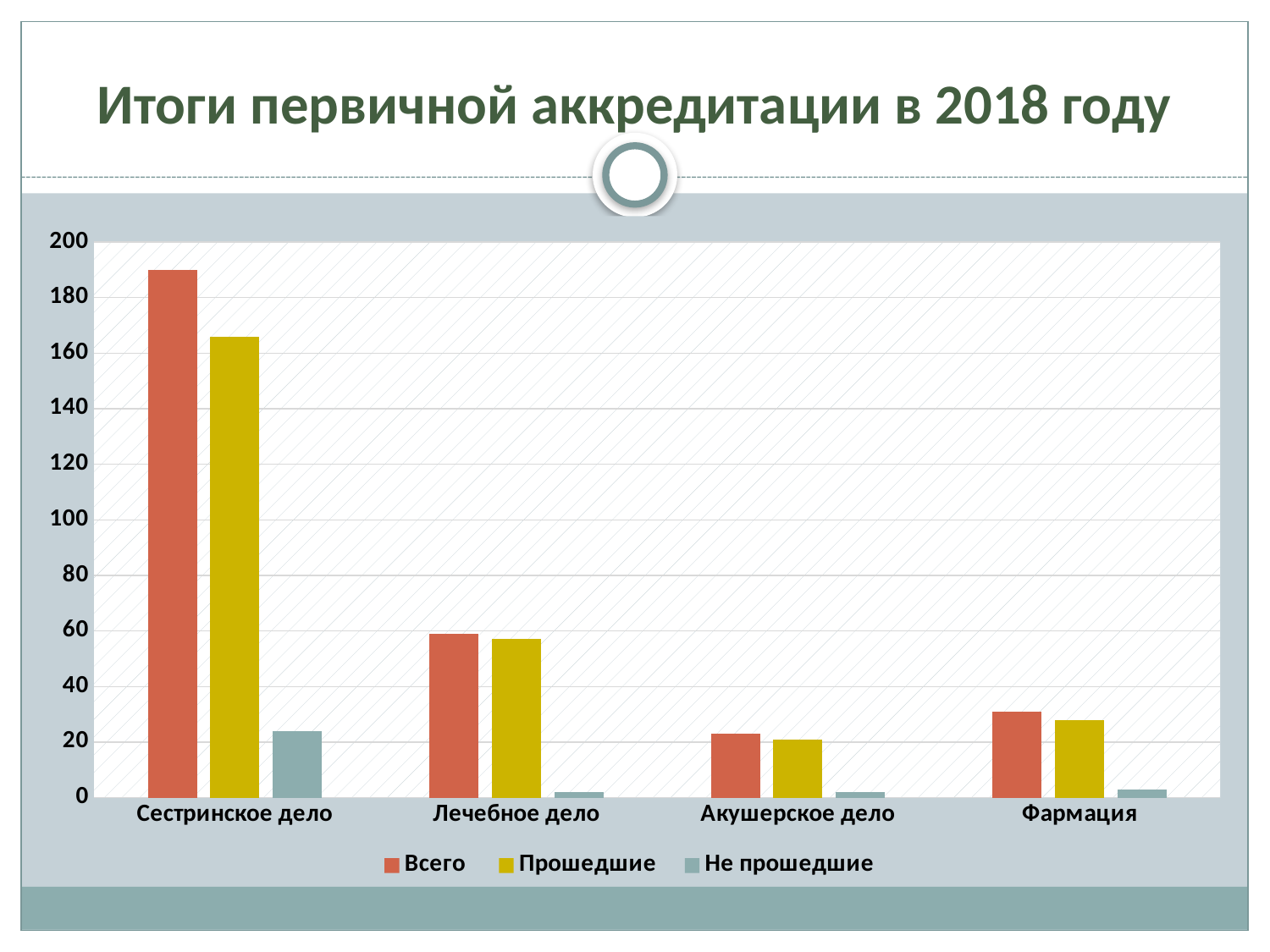
How many categories are shown on the x axis of the chart? 4 Which category has the lowest value for Всего? Акушерское дело Which category has the highest value for Не прошедшие? Сестринское дело Is the Всего value for Лечебное дело greater or less than 80? less Is the Всего value for Сестринское дело greater or less than 180? greater Which category has the highest value for Всего? Сестринское дело Is the Не прошедшие value for Сестринское дело greater or less than 40? less How many series does the chart legend list? 3 Which is larger: the Всего value for Лечебное дело or for Фармация? Лечебное дело What kind of chart is shown on the slide? bar chart What is the title of the slide containing the chart? Итоги первичной аккредитации в 2018 году